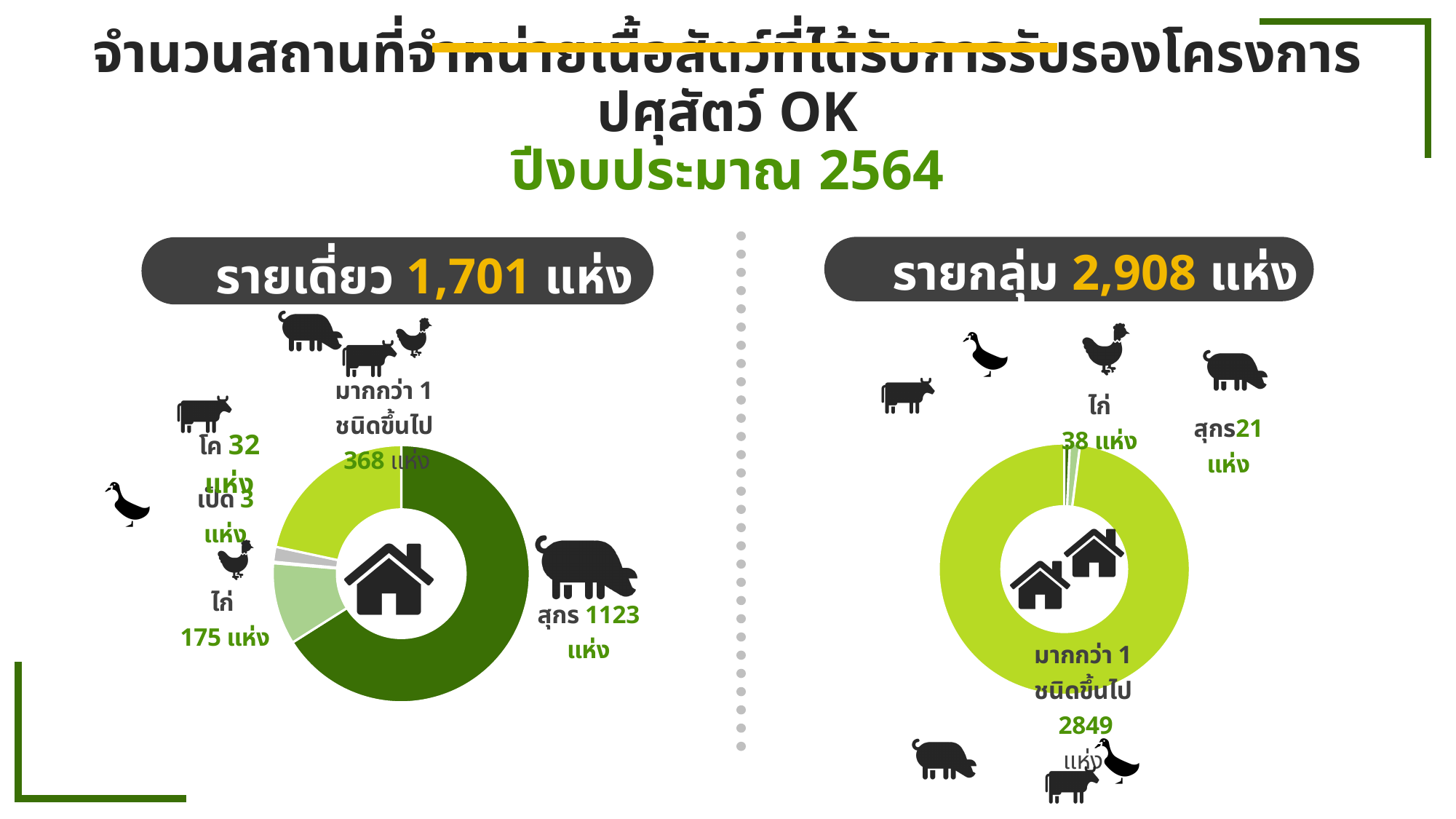
What fiscal year is shown in the slide title? ปีงบประมาณ 2564 In the right chart (รายกลุ่ม), what is the total number of locations across all categories? 2,908 แห่ง What kind of chart is used on the left side of the slide (รายเดี่ยว)? Donut chart In the left chart (รายเดี่ยว), how many locations are shown for สุกร? 1123 แห่ง In the right chart (รายกลุ่ม), how many locations are shown for มากกว่า 1 ชนิดขึ้นไป? 2849 แห่ง In the left chart (รายเดี่ยว), how many locations are shown for เป็ด? 3 แห่ง In the left chart (รายเดี่ยว), which category has the smallest value? เป็ด In the left chart (รายเดี่ยว), how many locations are shown for ไก่? 175 แห่ง In the left chart (รายเดี่ยว), which category has the largest value? สุกร In the right chart (รายกลุ่ม), which is larger, ไก่ or สุกร? ไก่ In the left chart (รายเดี่ยว), what is the difference between สุกร and มากกว่า 1 ชนิดขึ้นไป? 755 In the left chart (รายเดี่ยว), how many categories are shown? 5